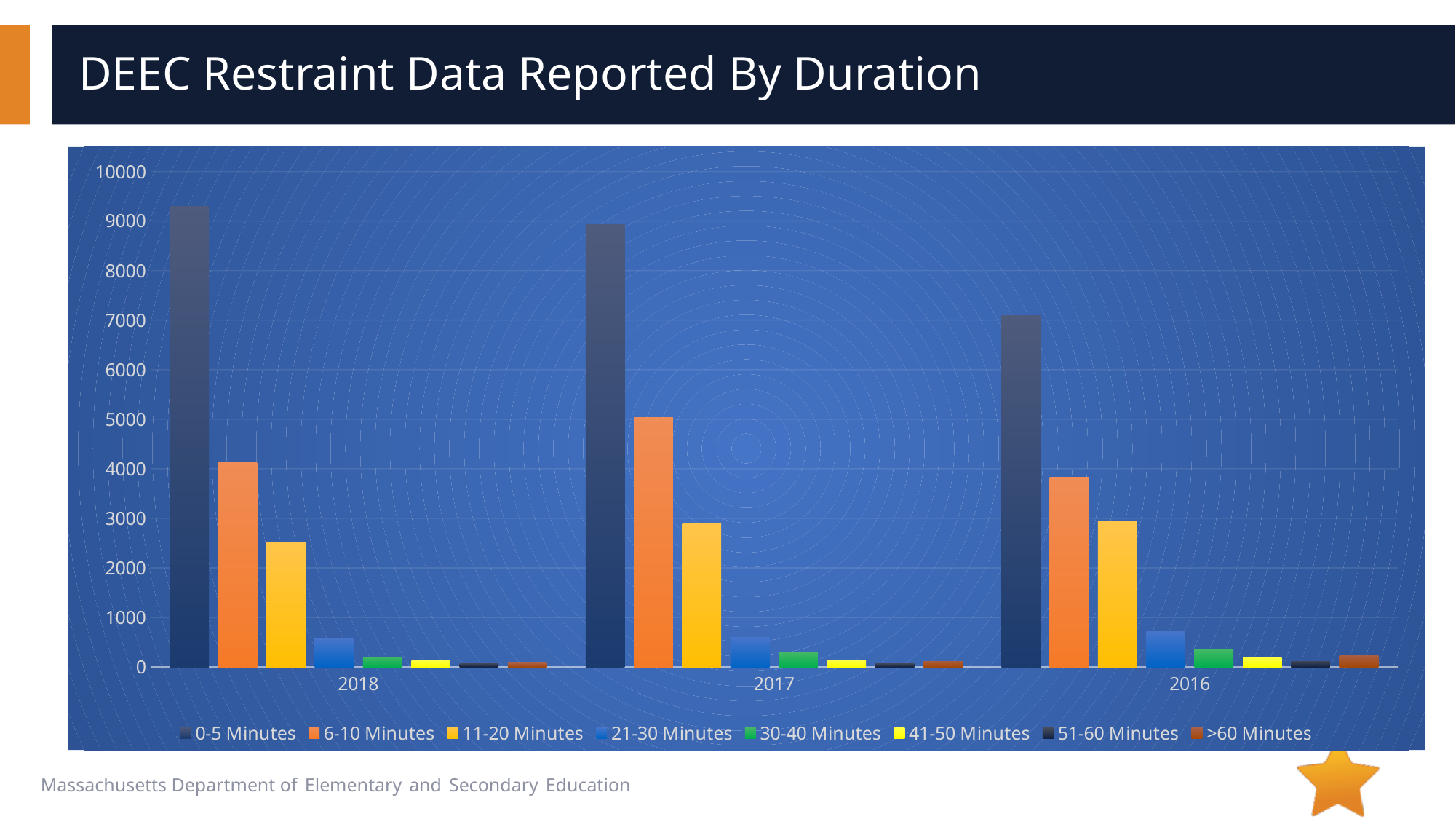
Is the value for 11-20 Minutes in 2018 greater or less than 3000? less Is the value for 6-10 Minutes in 2017 greater or less than 4000? greater Which year has the highest value for 0-5 Minutes? 2018 How many series does the legend list? 8 Do the 0-5 Minutes values rise or fall moving left to right along the x axis from 2018 to 2016? fall Is the value for 6-10 Minutes in 2016 greater or less than 4000? less What is the title of the chart? DEEC Restraint Data Reported By Duration Which is larger, the 6-10 Minutes value for 2017 or for 2018? 2017 How many years are shown on the x axis? 3 Which year has the lowest value for 0-5 Minutes? 2016 What kind of chart is shown on the slide? bar chart